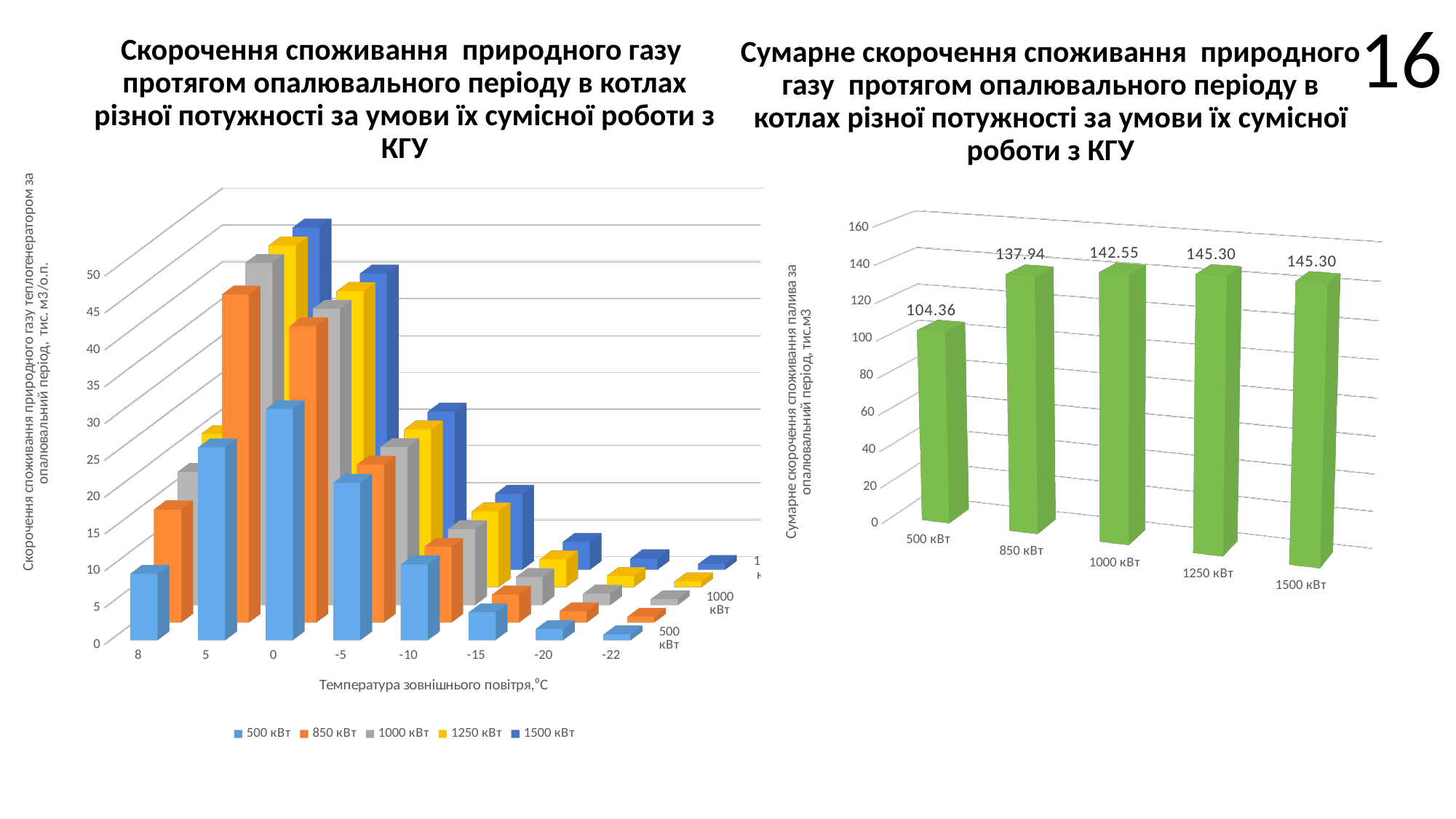
In the right chart (Сумарне скорочення споживання природного газу), how many categories are plotted? 5 In the left chart (Скорочення споживання природного газу), what is the x-axis title? Температура зовнішнього повітря, °C In the right chart (Сумарне скорочення споживання природного газу), which category has the lowest value? 500 кВт In the right chart (Сумарне скорочення споживання природного газу), what is the difference between the values for 850 кВт and 500 кВт? 33.58 In the right chart (Сумарне скорочення споживання природного газу), what is the value for 500 кВт? 104.36 In the left chart (Скорочення споживання природного газу), is the value for 500 кВт at temperature 0 greater or less than 20? greater What kind of chart is the right chart (Сумарне скорочення споживання природного газу)? bar chart In the right chart (Сумарне скорочення споживання природного газу), which is larger: the value for 850 кВт or the value for 1000 кВт? 1000 кВт In the left chart (Скорочення споживання природного газу), how many series does the legend list? 5 In the left chart (Скорочення споживання природного газу), how many temperature categories are shown on the x axis? 8 In the right chart (Сумарне скорочення споживання природного газу), do the values rise or fall from 500 кВт to 1250 кВт? rise In the right chart (Сумарне скорочення споживання природного газу), what is the value for 1000 кВт? 142.55